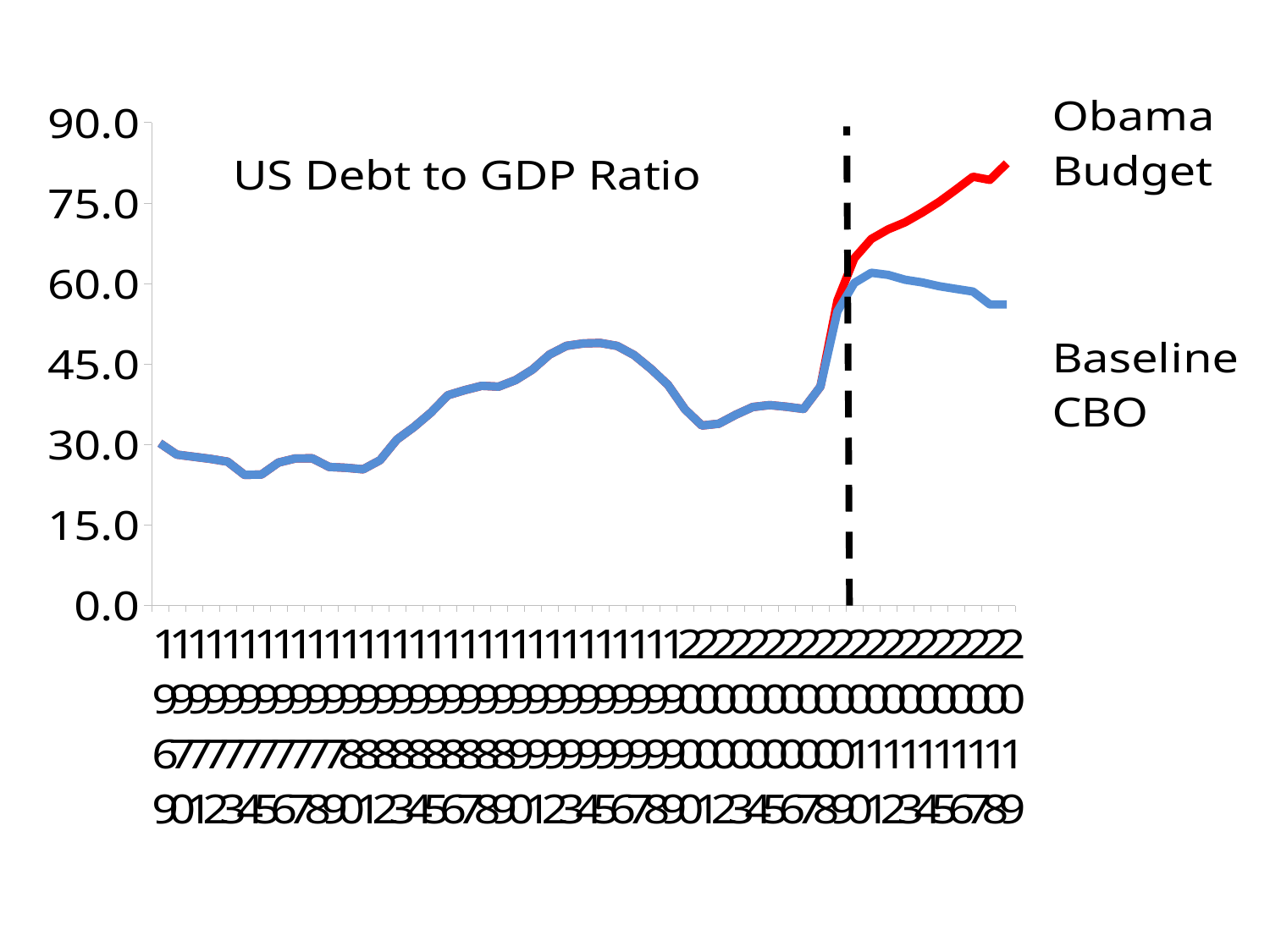
Which series is drawn in red? Obama Budget What is the title of the chart? US Debt to GDP Ratio In 2019, which series has the higher value, Obama Budget or Baseline CBO? Obama Budget Does the Baseline CBO line rise or fall from 2011 to 2019? fall How many series are plotted on the chart? 2 Does the Obama Budget line rise or fall from 2009 to 2019? rise Is the Baseline CBO value for 2001 greater or less than 45.0? less Is the Baseline CBO value for 1995 greater or less than 45.0? greater Is the Baseline CBO value for 2019 greater or less than 60.0? less What kind of chart is shown on the slide? line chart